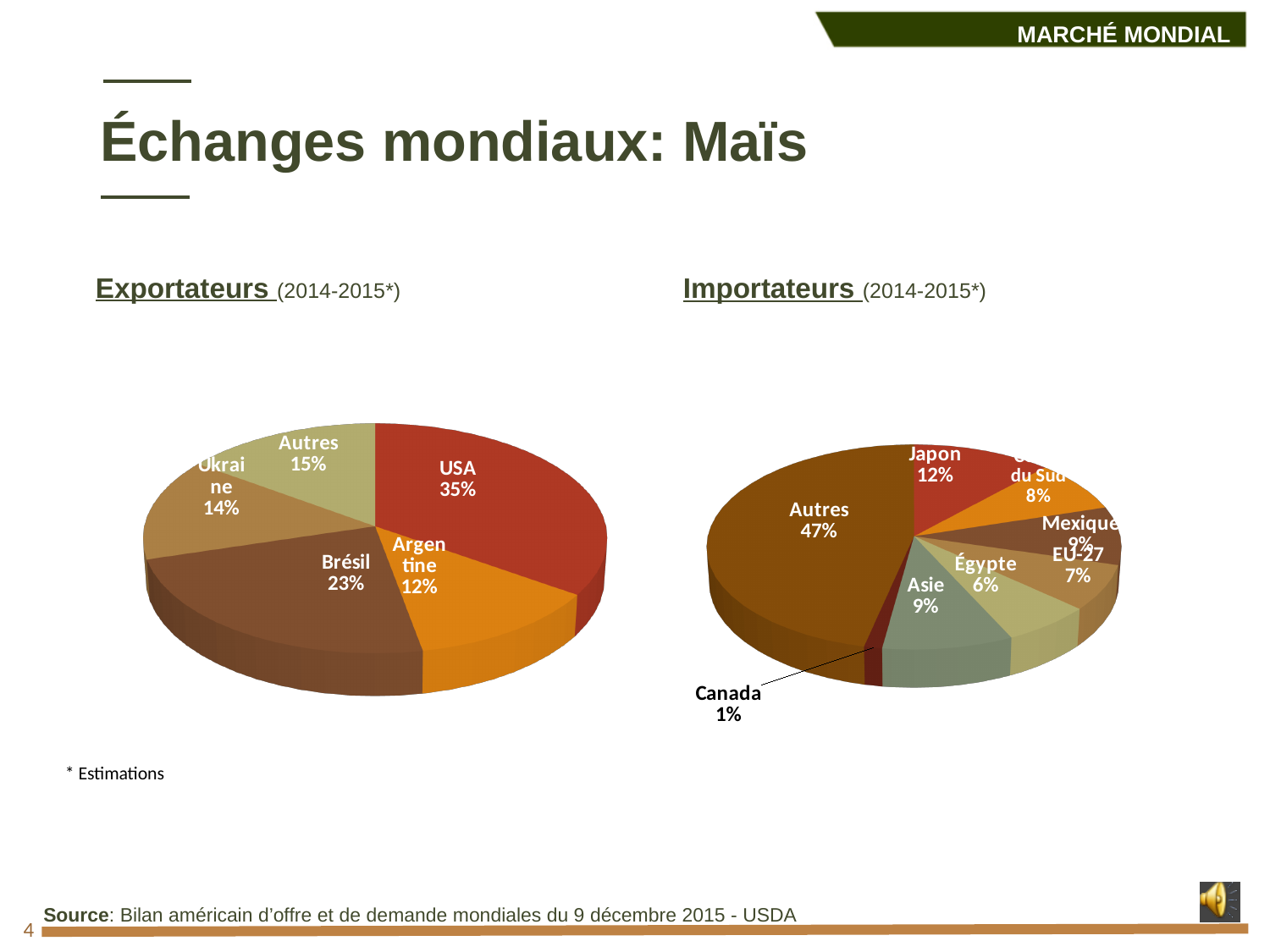
In the Exportateurs chart, which exporter has the smallest share? Argentine In the Importateurs chart, which is larger, the share of Égypte or the share of Asie? Asie In the Exportateurs chart, what share does USA hold? 35% In the Importateurs chart, which slice is the largest? Autres In the Exportateurs chart, which exporter has the largest share? USA In the Importateurs chart, what share does Canada hold? 1% In the Importateurs chart, which importer has the smallest share? Canada In the Exportateurs chart, what share does Brésil hold? 23% What type of chart is used for the Exportateurs data? Pie chart In the Exportateurs chart, what is the difference between the shares of USA and Brésil? 12% In the Exportateurs chart, how many slices does the pie have? 5 In the Importateurs chart, what share does Japon hold? 12%